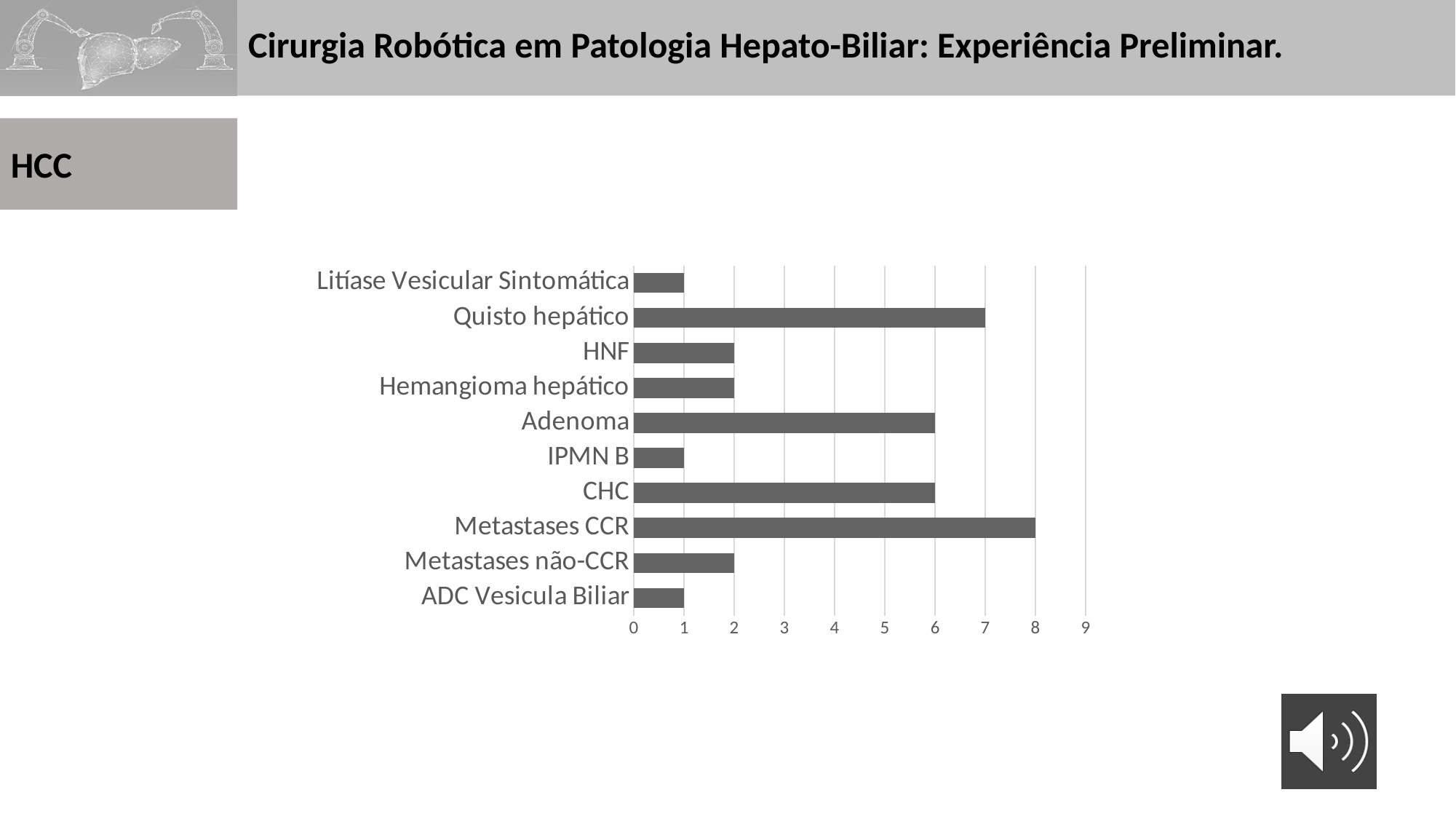
What is the value for Metastases CCR? 8 What is the value for IPMN B? 1 Which category has the highest value in the bar chart? Metastases CCR What is the value for Adenoma? 6 How many categories are plotted in the bar chart? 10 What is the highest value shown on the horizontal axis of the chart? 9 What is the value for HNF? 2 What is the value for Quisto hepático? 7 What kind of chart is shown on the slide? bar chart Is the value for Quisto hepático greater or less than 5? greater What is the difference between the values for Metastases CCR and Quisto hepático? 1 Which is larger, the value for Adenoma or the value for Hemangioma hepático? Adenoma